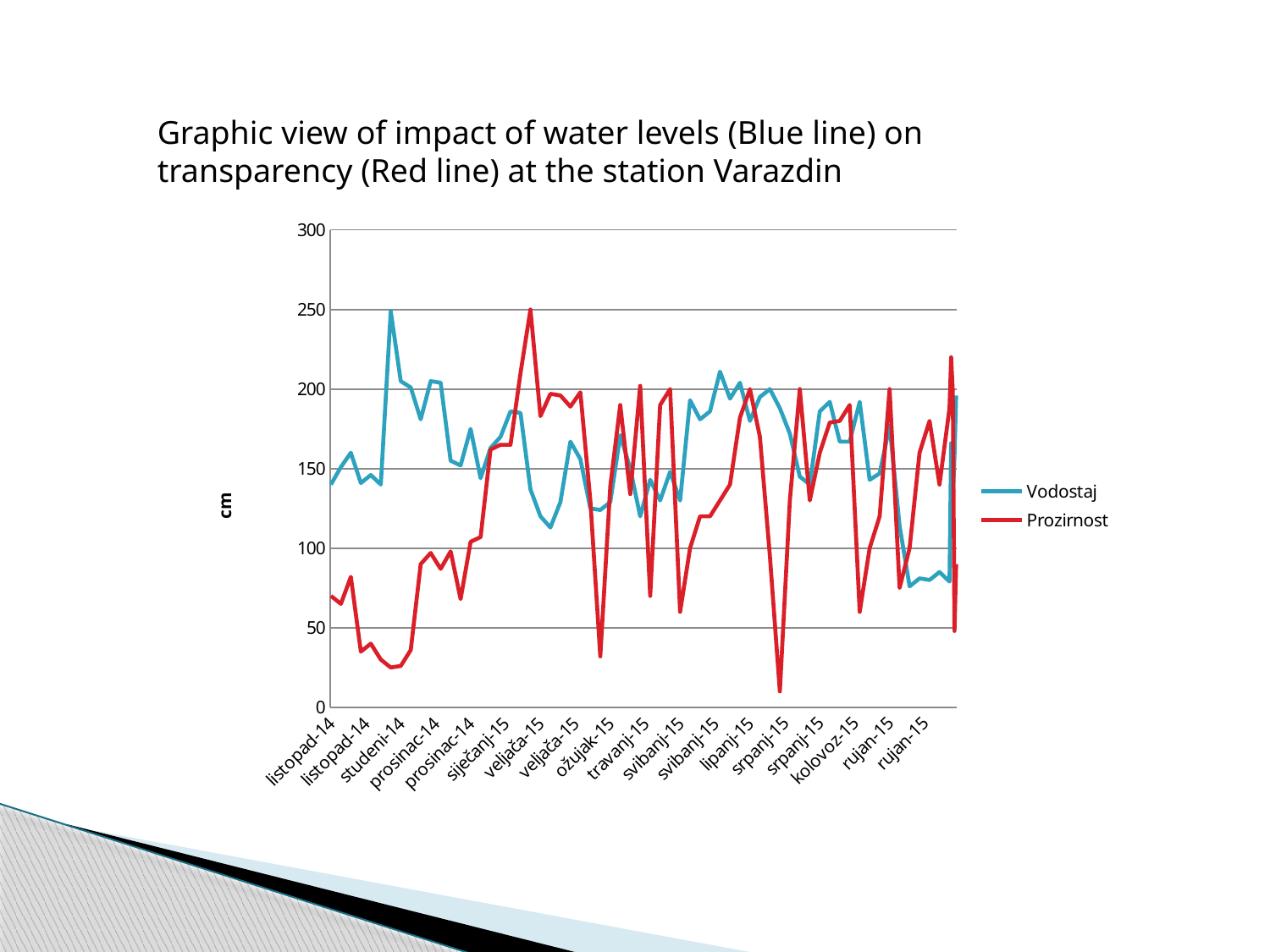
Does the Prozirnost line rise or fall between studeni-14 and veljača-15? rise Is the highest value reached by the Prozirnost line greater or less than 200? greater How many series does the legend list? 2 What kind of chart is shown on the slide? Line chart Which series is drawn in blue? Vodostaj Is the lowest value reached by the Prozirnost line greater or less than 50? less What are the two series named in the legend? Vodostaj and Prozirnost Is the first plotted value of the Prozirnost series greater or less than 100? less Which series reaches the lower minimum value, Vodostaj or Prozirnost? Prozirnost What unit is shown on the vertical axis? cm